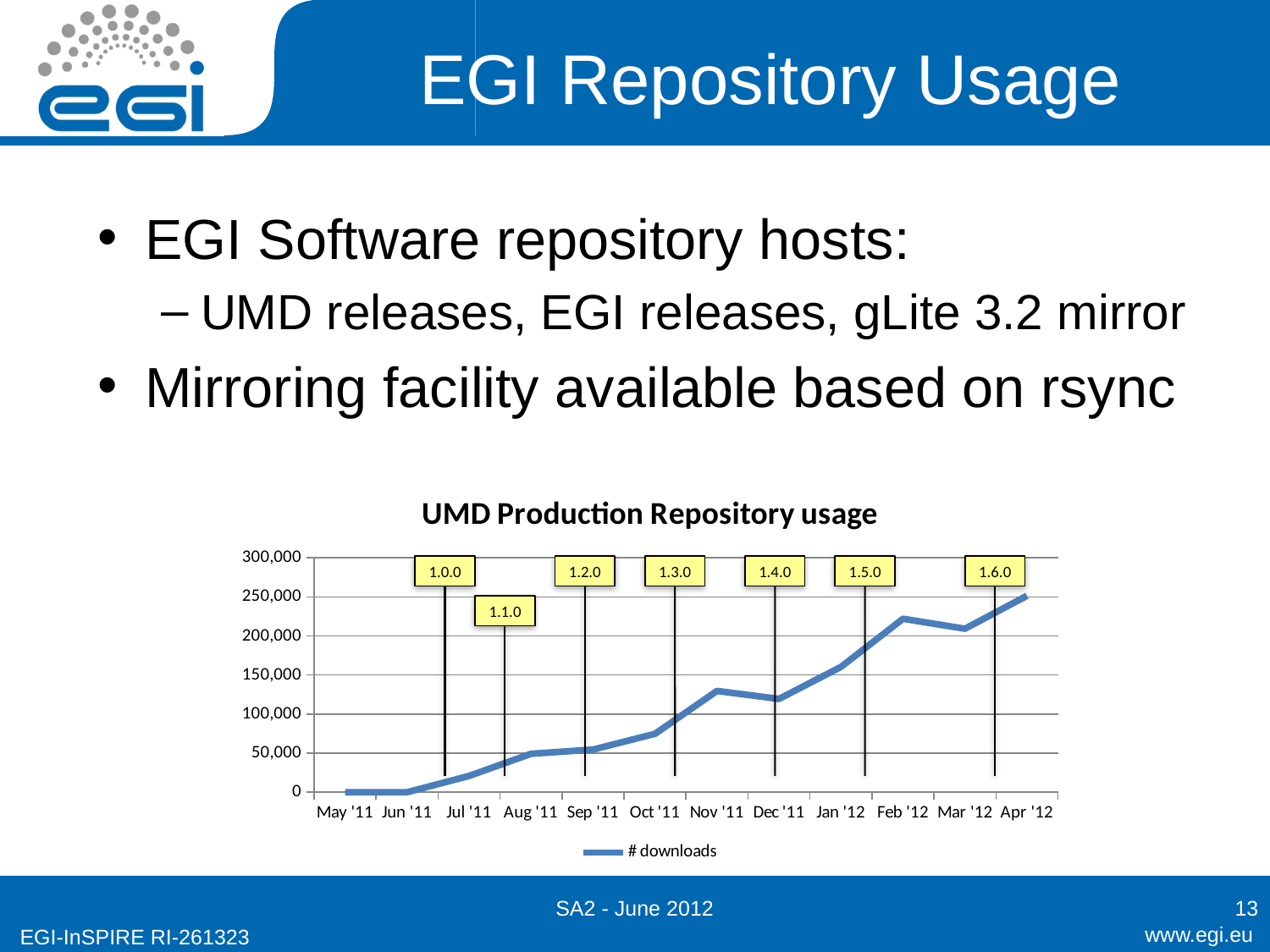
Do the download values generally rise or fall from May '11 to Apr '12? rise What kind of chart is shown on the slide? line chart What is the title of the chart? UMD Production Repository usage Is the value for Oct '11 greater or less than 100,000? less Is the value for Nov '11 greater or less than 100,000? greater How many series does the chart legend list? 1 Which month has the highest number of downloads? Apr '12 Which has more downloads, Dec '11 or Feb '12? Feb '12 Is the value for Jul '11 greater or less than 50,000? less How many months are plotted along the x axis? 12 What is the name of the series shown in the legend? # downloads